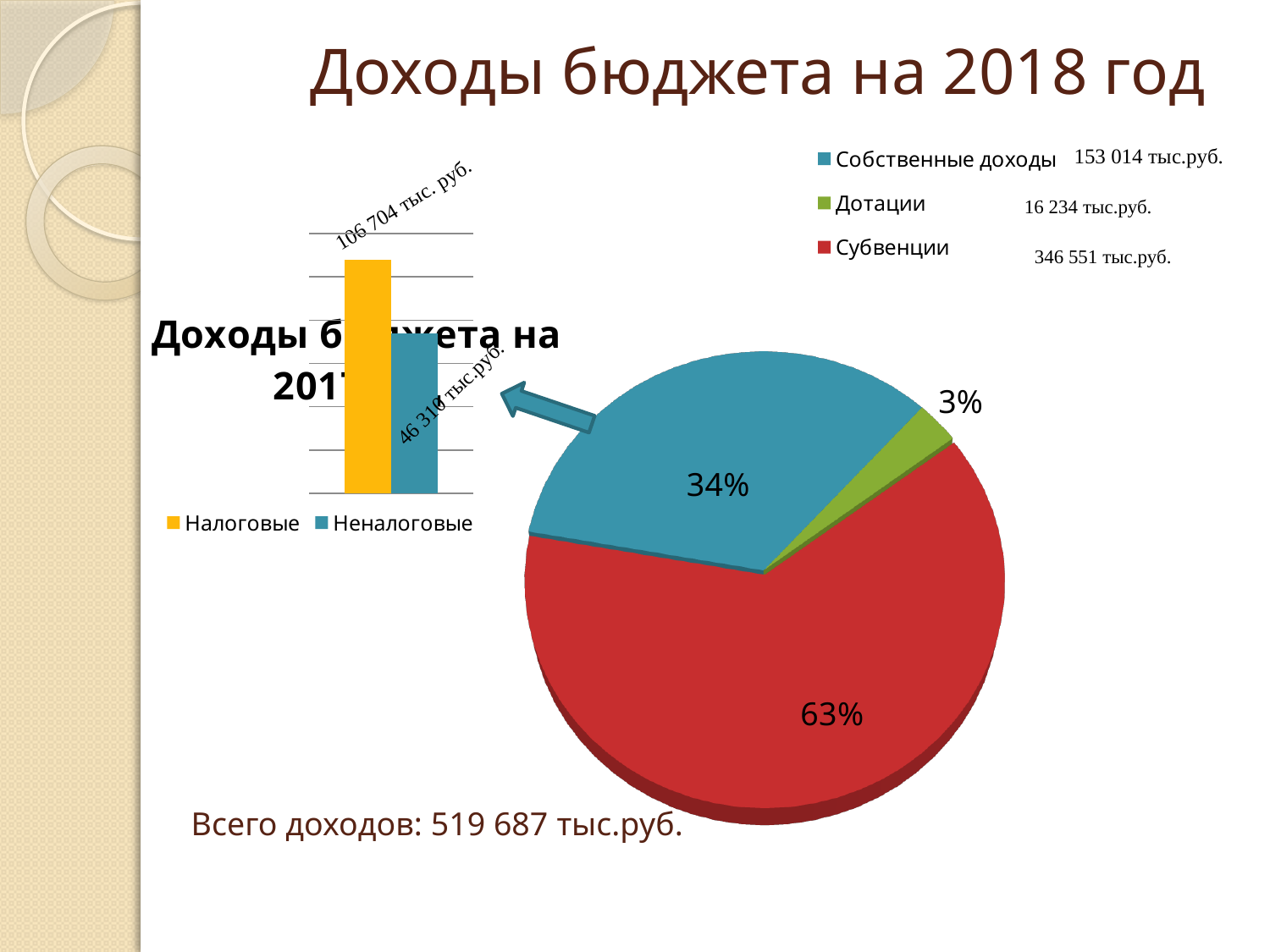
What type of chart is the chart on the left of the slide? bar chart In the pie chart, what share of the budget revenue is Дотации? 3% In the pie chart, which category has the smallest slice? Дотации In the pie chart, what is the value shown for Собственные доходы? 153 014 тыс.руб. In the pie chart, what is the difference between Субвенции and Собственные доходы? 193 537 тыс.руб. In the pie chart, how many categories does the legend list? 3 In the pie chart, what is the value shown for Дотации? 16 234 тыс.руб. In the pie chart, what share of the budget revenue is Собственные доходы? 34% In the bar chart on the left, which category is larger, Налоговые or Неналоговые? Налоговые In the pie chart, which category has the largest slice? Субвенции In the pie chart, what share of the budget revenue is Субвенции? 63% In the bar chart on the left, what is the value for Налоговые? 106 704 тыс. руб.